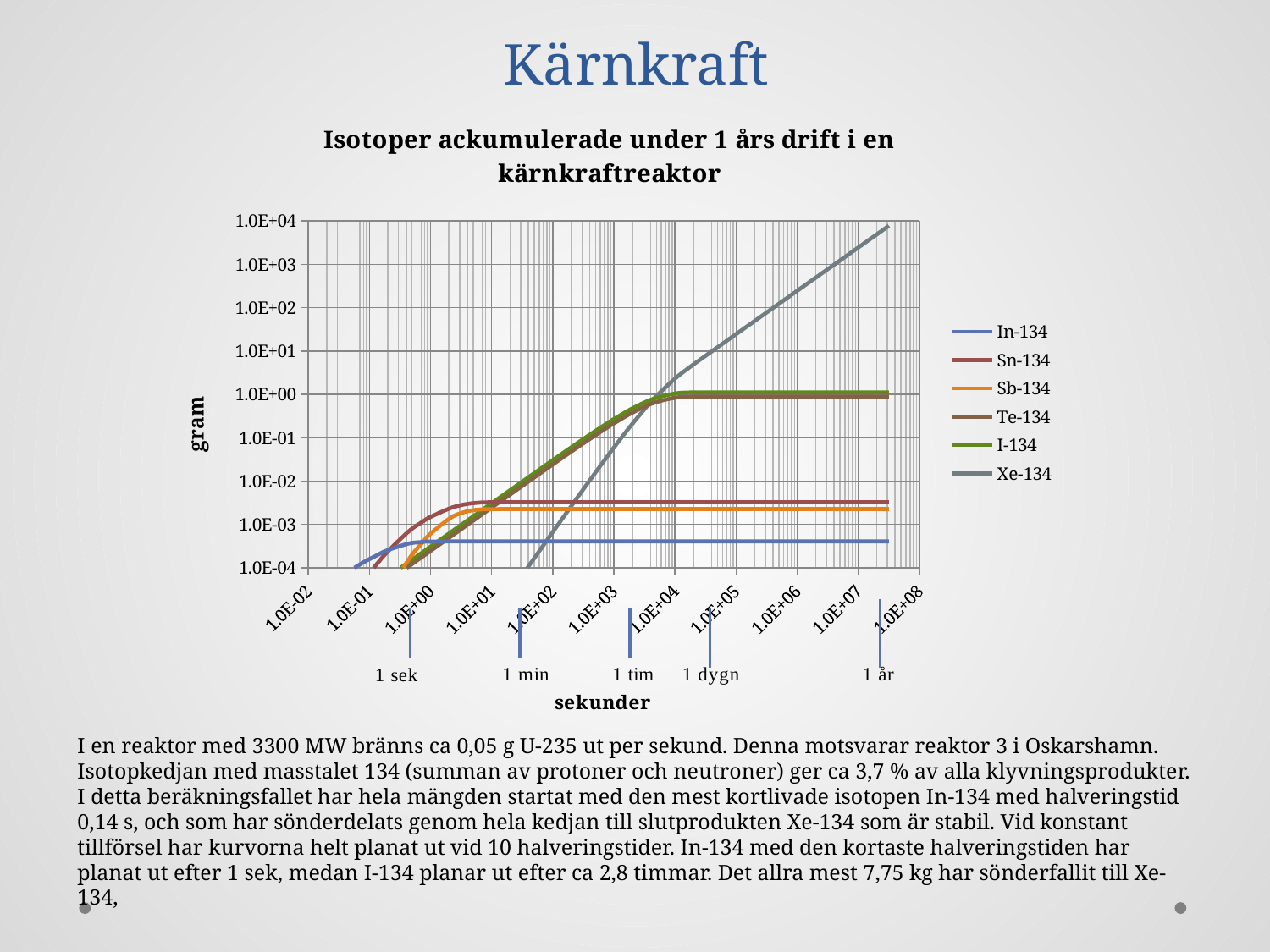
Does the Xe-134 curve rise or fall as time increases along the x axis? rise What is the label of the y axis? gram What kind of chart is shown on the slide? line chart Is the final value of Xe-134 greater or less than 1.0E+03 gram? greater How many series does the legend list? 6 At the right end of the chart, which is larger: the value for Sn-134 or the value for In-134? Sn-134 Is the plateau value of In-134 greater or less than 1.0E-03 gram? less Is the plateau value of Sn-134 greater or less than 1.0E-03 gram? greater Which series has the highest value at the right end of the x axis (1.0E+08 seconds)? Xe-134 What is the title of the chart? Isotoper ackumulerade under 1 års drift i en kärnkraftreaktor Which series has the lowest value at the right end of the x axis (1.0E+08 seconds)? In-134